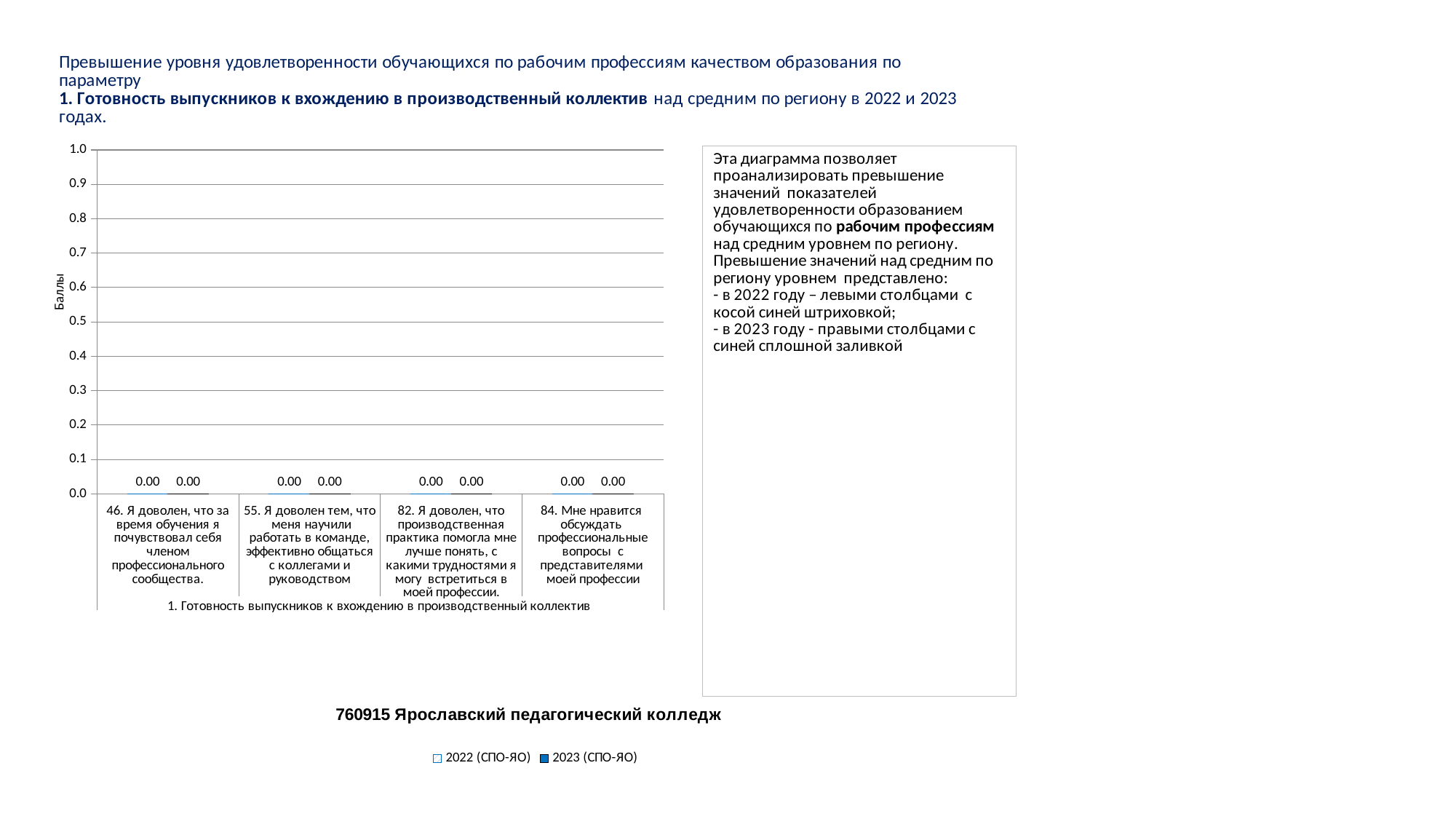
How many categories are shown on the x axis of the chart? 4 What kind of chart is shown on the slide? bar chart What is the value for 2022 (СПО-ЯО) for category 46 (Я доволен, что за время обучения я почувствовал себя членом профессионального сообщества)? 0.00 What is the value for 2023 (СПО-ЯО) for category 84 (Мне нравится обсуждать профессиональные вопросы с представителями моей профессии)? 0.00 Do the values for 2022 (СПО-ЯО) rise, fall, or stay the same across the categories? stay the same What is the label of the y axis of the chart? Баллы What is the value for 2022 (СПО-ЯО) for category 82 (Я доволен, что производственная практика помогла мне лучше понять...)? 0.00 What is the value for 2023 (СПО-ЯО) for category 55 (Я доволен тем, что меня научили работать в команде)? 0.00 What are the two series names listed in the chart legend? 2022 (СПО-ЯО) and 2023 (СПО-ЯО) How many series does the legend list? 2 What is the difference between the 2022 (СПО-ЯО) and 2023 (СПО-ЯО) values for category 46? 0.00 Is the value for 2023 (СПО-ЯО) for category 82 greater or less than 0.5? less